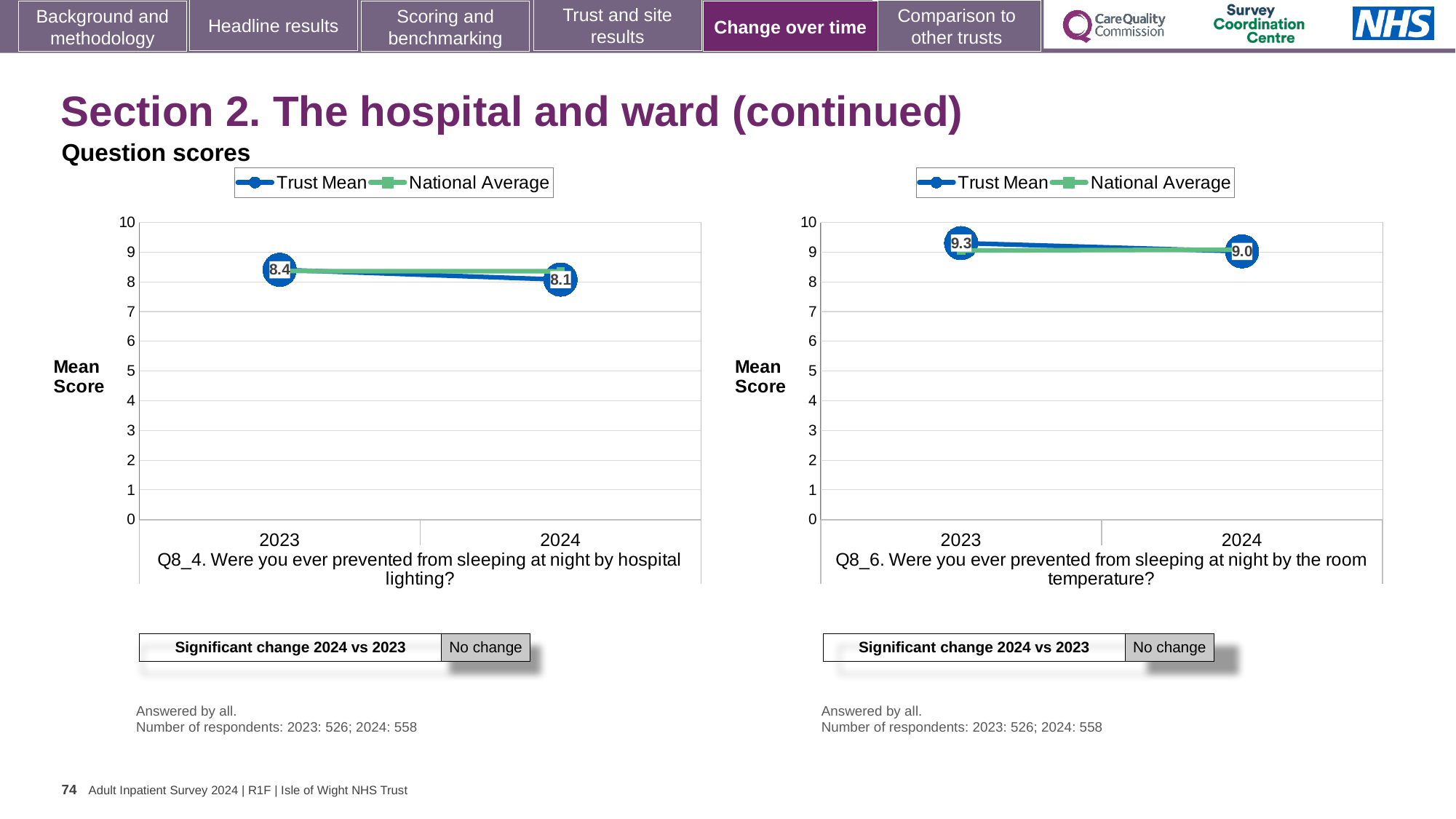
In the Q8_6 chart (right), is the Trust Mean for 2023 higher or lower than the Trust Mean for 2024? higher In the Q8_4 chart (left), by how much did the Trust Mean change from 2023 to 2024? 0.3 How many years are shown on the x axis of the Q8_6 chart (right)? 2 What type of chart is used for the Q8_6 chart (right)? line chart In the Q8_4 chart (left), what is the Trust Mean score for 2023? 8.4 In the Q8_6 chart (right), what is the Trust Mean score for 2023? 9.3 In the Q8_6 chart (right), by how much did the Trust Mean change from 2023 to 2024? 0.3 In the Q8_4 chart (left), what is the Trust Mean score for 2024? 8.1 In the Q8_4 chart (left), does the Trust Mean rise or fall from 2023 to 2024? fall How many series does the legend of the Q8_4 chart (left) list? 2 In the Q8_4 chart (left), is the National Average for 2024 greater or less than 7? greater In the Q8_6 chart (right), what is the Trust Mean score for 2024? 9.0